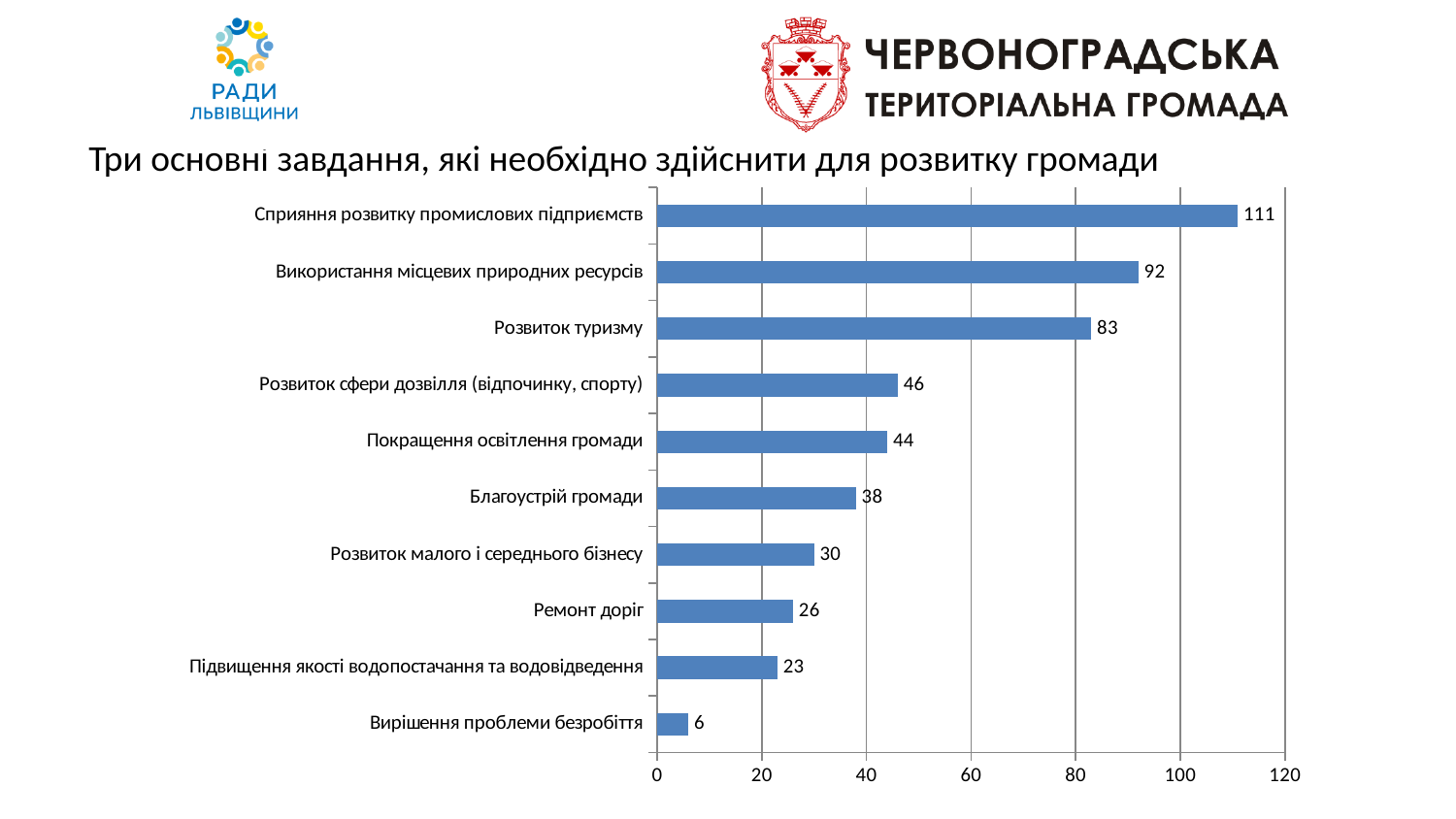
Which is larger: the value for "Благоустрій громади" or the value for "Розвиток малого і середнього бізнесу"? Благоустрій громади Is the value for "Покращення освітлення громади" greater or less than 40? greater What is the difference between the values for "Сприяння розвитку промислових підприємств" and "Вирішення проблеми безробіття"? 105 Which category has the highest value? Сприяння розвитку промислових підприємств What is the value for "Сприяння розвитку промислових підприємств"? 111 How many categories are shown in the chart? 10 What is the value for "Ремонт доріг"? 26 What is the title of the chart? Три основні завдання, які необхідно здійснити для розвитку громади What kind of chart is shown on the slide? bar chart What is the value for "Розвиток туризму"? 83 Which category has the lowest value? Вирішення проблеми безробіття What is the difference between the values for "Використання місцевих природних ресурсів" and "Розвиток туризму"? 9